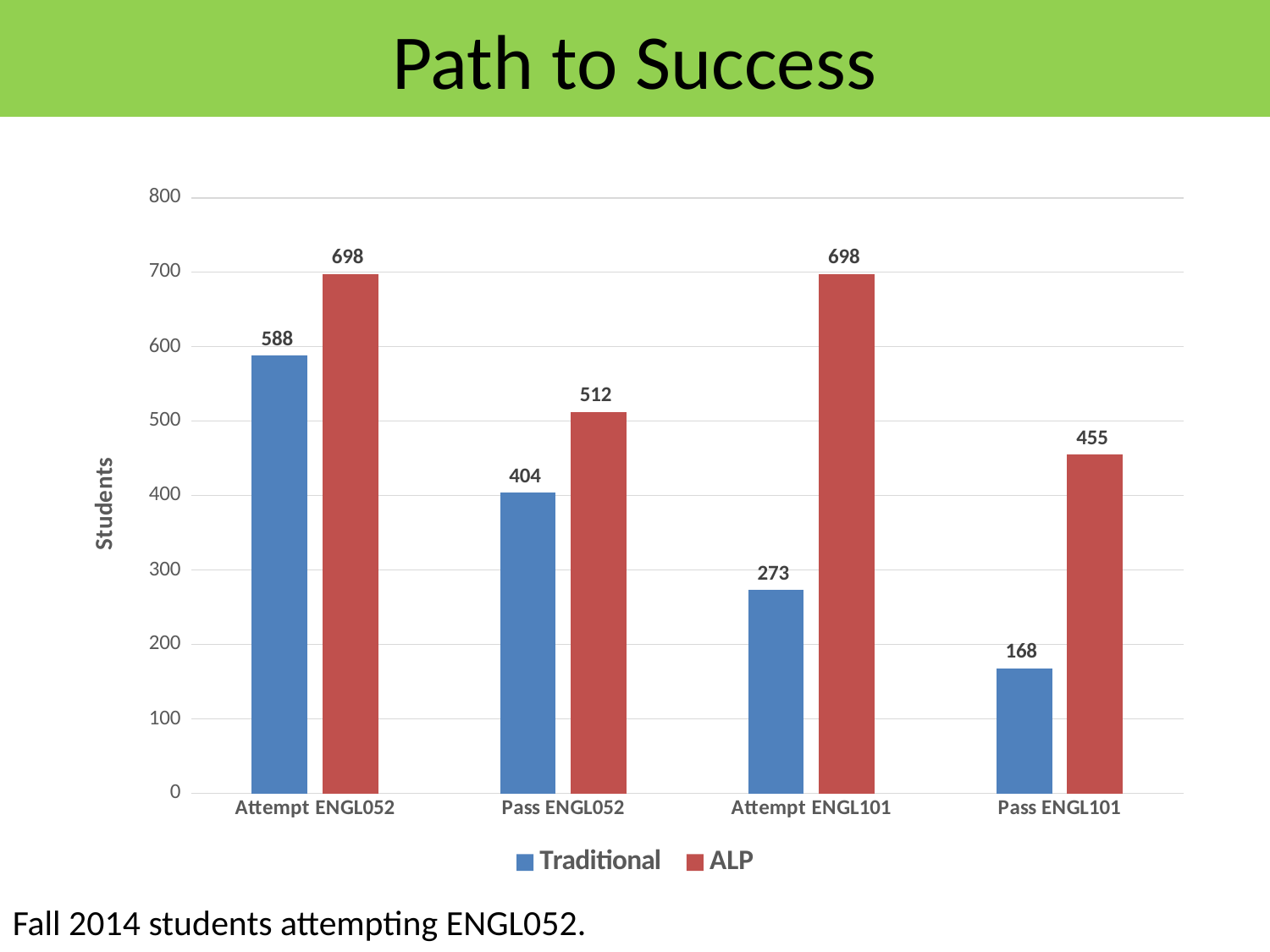
What is the difference between the ALP and Traditional values for Pass ENGL052? 108 How many series does the legend list? 2 Which category has the lowest Traditional value? Pass ENGL101 Do the Traditional values rise or fall from Attempt ENGL052 to Pass ENGL101? fall What is the ALP value for Pass ENGL101? 455 Which is larger, the Traditional value for Attempt ENGL101 or the Traditional value for Pass ENGL052? Pass ENGL052 What is the label on the vertical axis? Students How many categories are shown on the x axis? 4 What kind of chart is shown on the slide? bar chart What is the Traditional value for Attempt ENGL052? 588 Which category has the highest Traditional value? Attempt ENGL052 What is the Traditional value for Pass ENGL101? 168